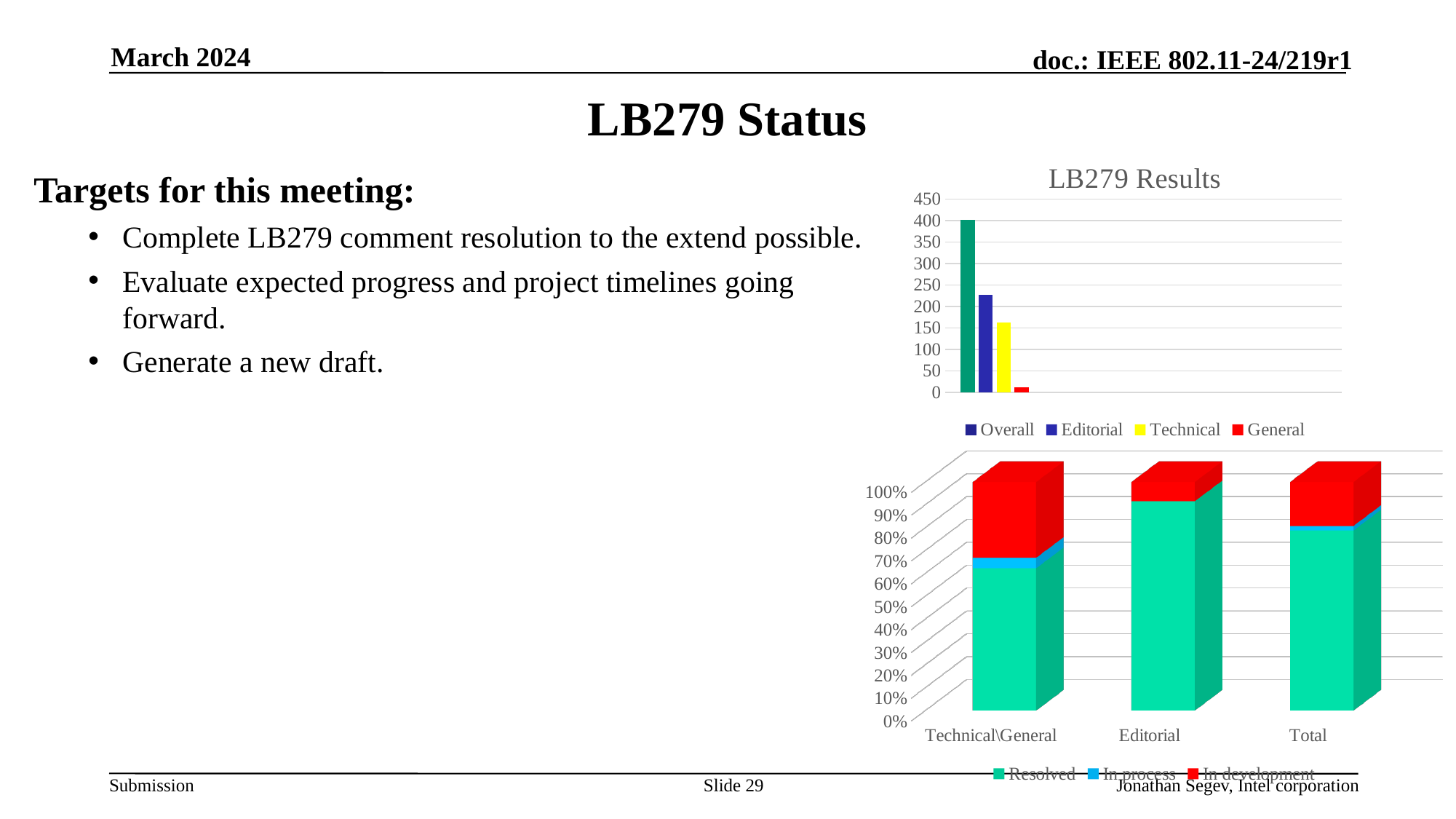
In the 'LB279 Results' chart, what is the highest value shown on the vertical axis? 450 In the 'LB279 Results' chart, is the value for Technical greater or less than 200? less How many series does the legend of the 'LB279 Results' chart list? 4 How many series does the legend of the stacked bar chart at the bottom right list? 3 In the stacked bar chart at the bottom right, which category has the largest Resolved share? Editorial In the stacked bar chart at the bottom right, is the Resolved share for Technical\General greater or less than 50%? greater In the 'LB279 Results' chart, which series has the highest value? Overall In the 'LB279 Results' chart, which series has the lowest value? General What type of chart is the 'LB279 Results' chart at the top right? bar chart In the 'LB279 Results' chart, which is larger, the value for Editorial or the value for Technical? Editorial How many categories are shown on the x axis of the stacked bar chart at the bottom right? 3 In the 'LB279 Results' chart, is the value for Overall greater or less than 350? greater